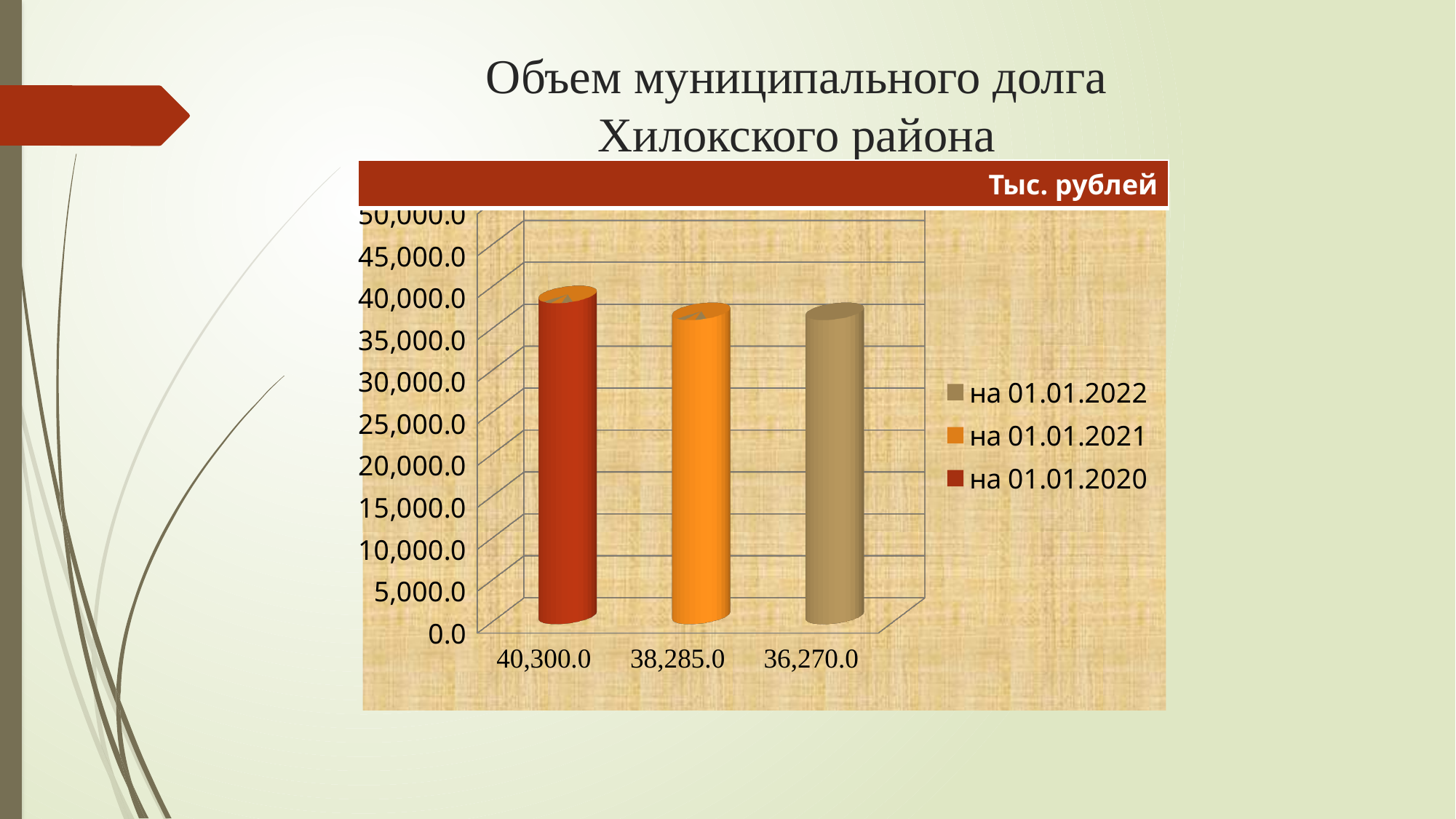
How many entries does the legend list? 3 Is the value for на 01.01.2022 greater or less than 40,000.0? less What is the value of the bar for на 01.01.2022? 36,270.0 How many bars are plotted in the chart? 3 What unit is shown in the header band of the chart? Тыс. рублей Which date has the lowest municipal debt value? на 01.01.2022 What is the value of the bar for на 01.01.2021? 38,285.0 Which is larger, the value for на 01.01.2020 or the value for на 01.01.2021? на 01.01.2020 What is the difference between the values for на 01.01.2021 and на 01.01.2022? 2,015.0 Which date has the highest municipal debt value? на 01.01.2020 What is the value of the bar for на 01.01.2020? 40,300.0 What is the difference between the values for на 01.01.2020 and на 01.01.2022? 4,030.0